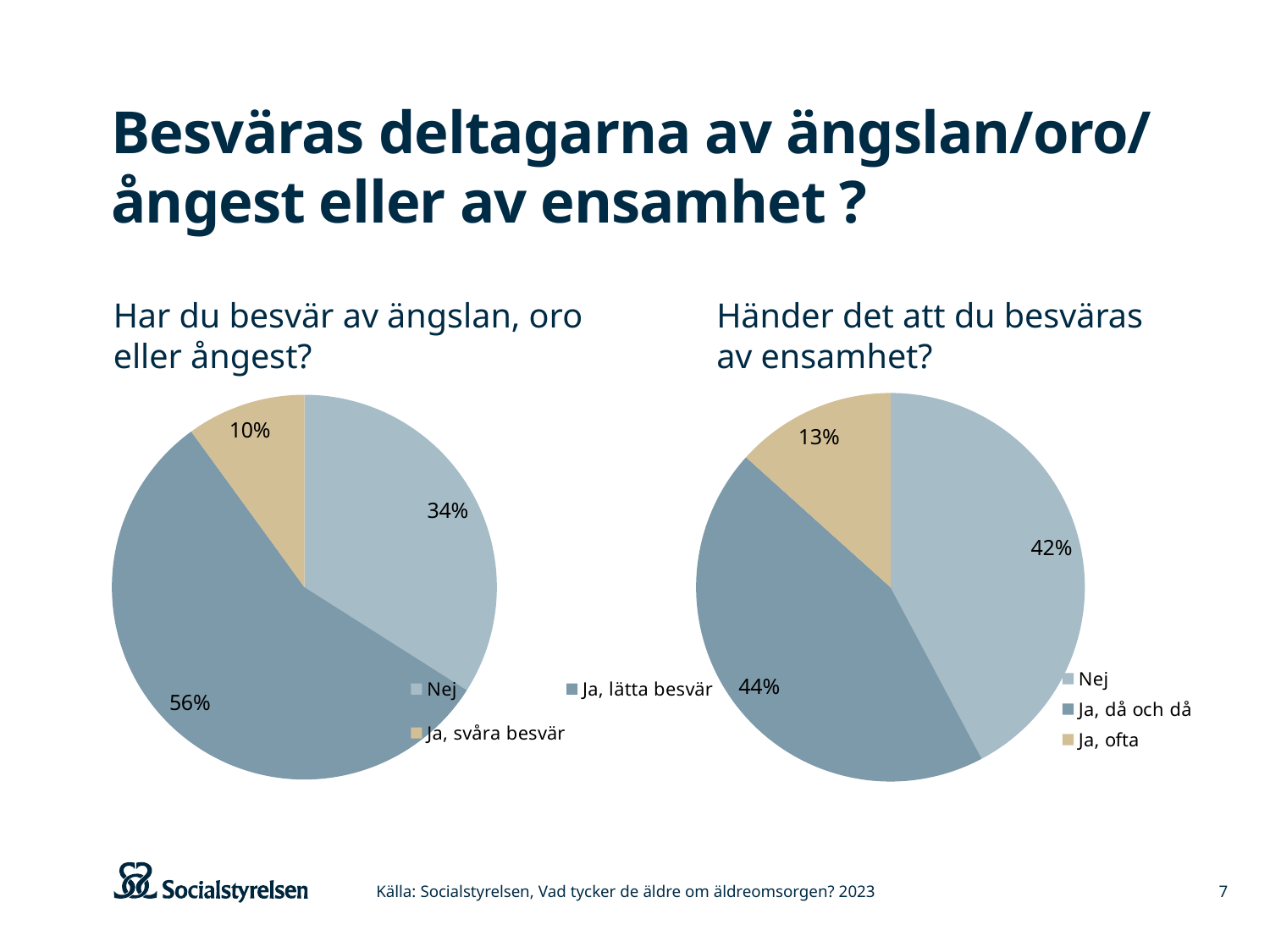
In the chart 'Har du besvär av ängslan, oro eller ångest?', what is the difference in percentage points between 'Ja, lätta besvär' and 'Nej'? 22 percentage points In the chart 'Har du besvär av ängslan, oro eller ångest?', what share of respondents answered 'Ja, lätta besvär'? 56% In the chart 'Händer det att du besväras av ensamhet?', what share of respondents answered 'Ja, då och då'? 44% In the chart 'Händer det att du besväras av ensamhet?', which is larger: the share for 'Nej' or the share for 'Ja, då och då'? Ja, då och då In the chart 'Har du besvär av ängslan, oro eller ångest?', what share of respondents answered 'Nej'? 34% In the chart 'Har du besvär av ängslan, oro eller ångest?', what share of respondents answered 'Ja, svåra besvär'? 10% In the chart 'Händer det att du besväras av ensamhet?', which answer has the smallest share? Ja, ofta In the chart 'Har du besvär av ängslan, oro eller ångest?', which answer has the largest share? Ja, lätta besvär What type of chart is used on the left side of the slide? Pie chart How many categories does the legend of the chart 'Händer det att du besväras av ensamhet?' list? 3 In the chart 'Händer det att du besväras av ensamhet?', what share of respondents answered 'Nej'? 42% In the chart 'Händer det att du besväras av ensamhet?', what share of respondents answered 'Ja, ofta'? 13%